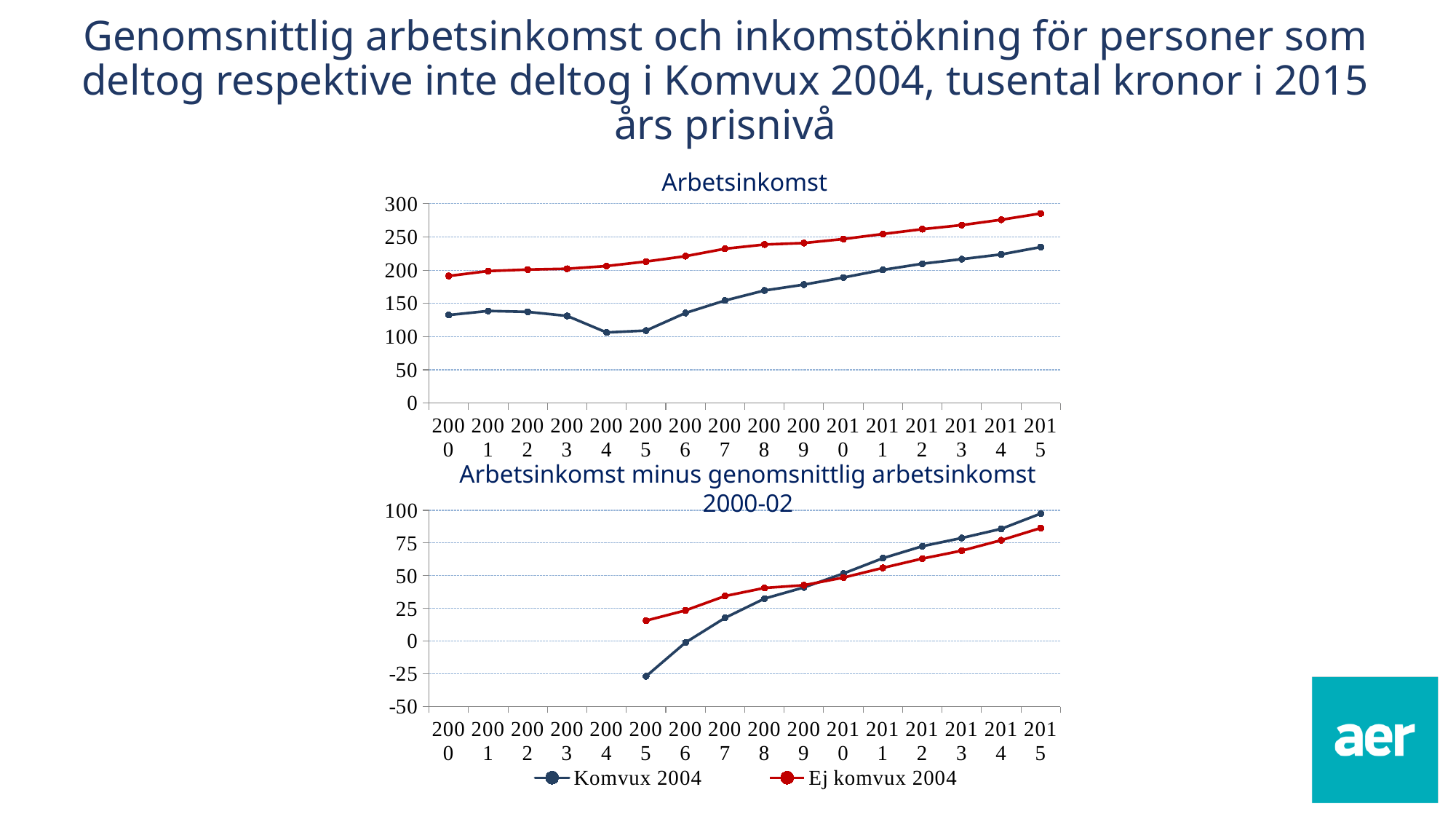
In the top chart "Arbetsinkomst", which series has the higher value in 2010? Ej komvux 2004 In the top chart "Arbetsinkomst", is the value for Komvux 2004 in 2004 greater or less than 150? less Which colour is used for the Ej komvux 2004 series? red How many series does the legend list? 2 In the top chart "Arbetsinkomst", is the value for Ej komvux 2004 in 2015 greater or less than 250? greater In the top chart "Arbetsinkomst", how many years are shown on the x axis? 16 In the bottom chart "Arbetsinkomst minus genomsnittlig arbetsinkomst 2000-02", which series has the higher value in 2015? Komvux 2004 In the bottom chart "Arbetsinkomst minus genomsnittlig arbetsinkomst 2000-02", is the value for Komvux 2004 in 2005 greater or less than 0? less In the top chart "Arbetsinkomst", does the Ej komvux 2004 series rise or fall from 2000 to 2015? rise In the top chart "Arbetsinkomst", in which year does the Ej komvux 2004 series reach its highest value? 2015 In the bottom chart "Arbetsinkomst minus genomsnittlig arbetsinkomst 2000-02", how many data points does the Komvux 2004 line have? 11 What kind of chart is the top chart titled "Arbetsinkomst"? line chart